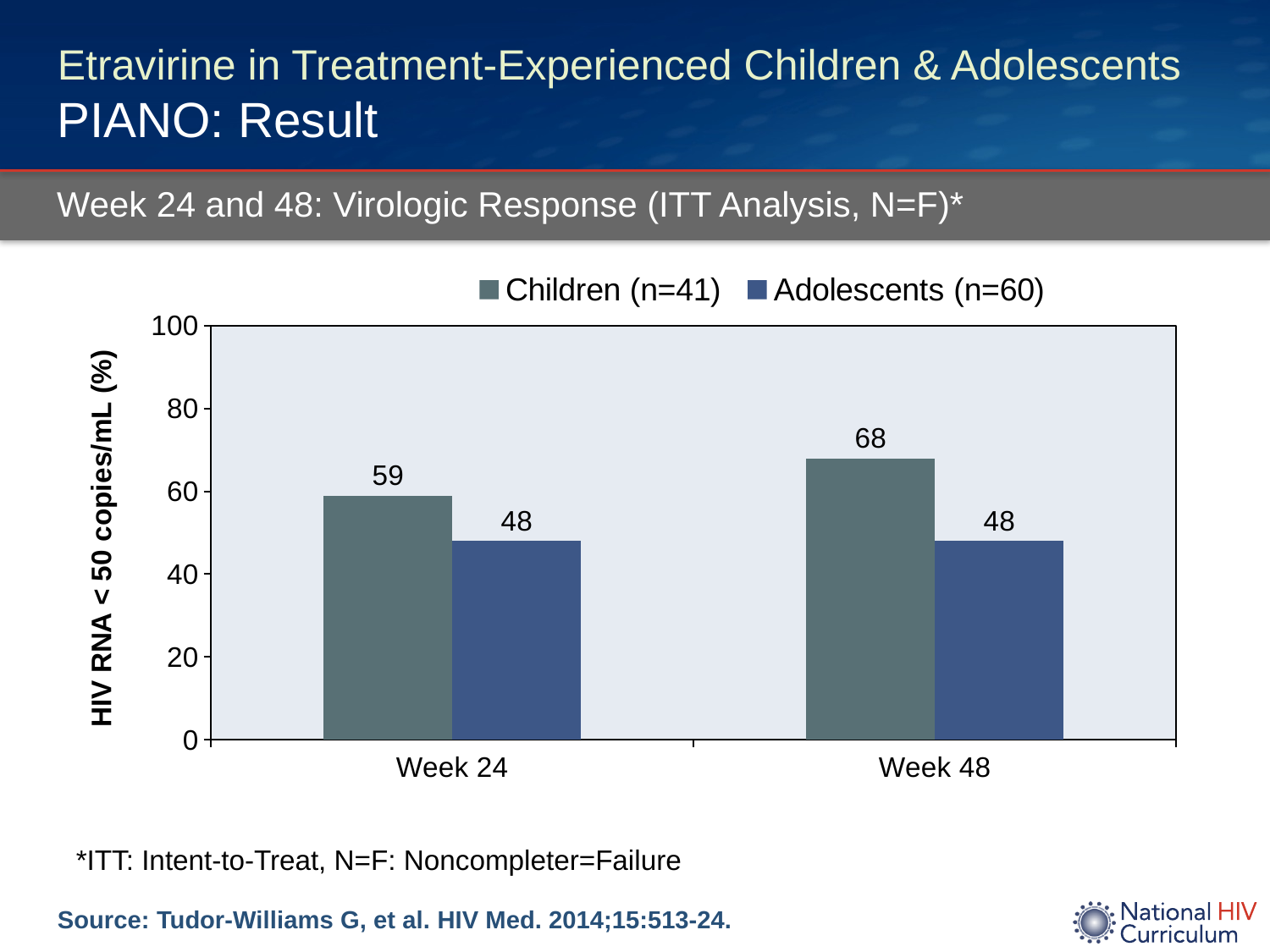
What is the value for Children (n=41) at Week 24? 59 Which bar has the highest value on the chart? Children (n=41) at Week 48 How many categories are shown on the x axis? 2 What kind of chart is shown on the slide? Bar chart What is the label of the y axis? HIV RNA < 50 copies/mL (%) What is the difference between the Children (n=41) and Adolescents (n=60) values at Week 24? 11 What is the difference between the Children (n=41) values at Week 48 and Week 24? 9 How many series does the legend list? 2 What is the value for Children (n=41) at Week 48? 68 Is the value for Children (n=41) at Week 48 greater or less than 60? greater What is the value for Adolescents (n=60) at Week 48? 48 Which is larger at Week 48: the value for Children (n=41) or Adolescents (n=60)? Children (n=41)